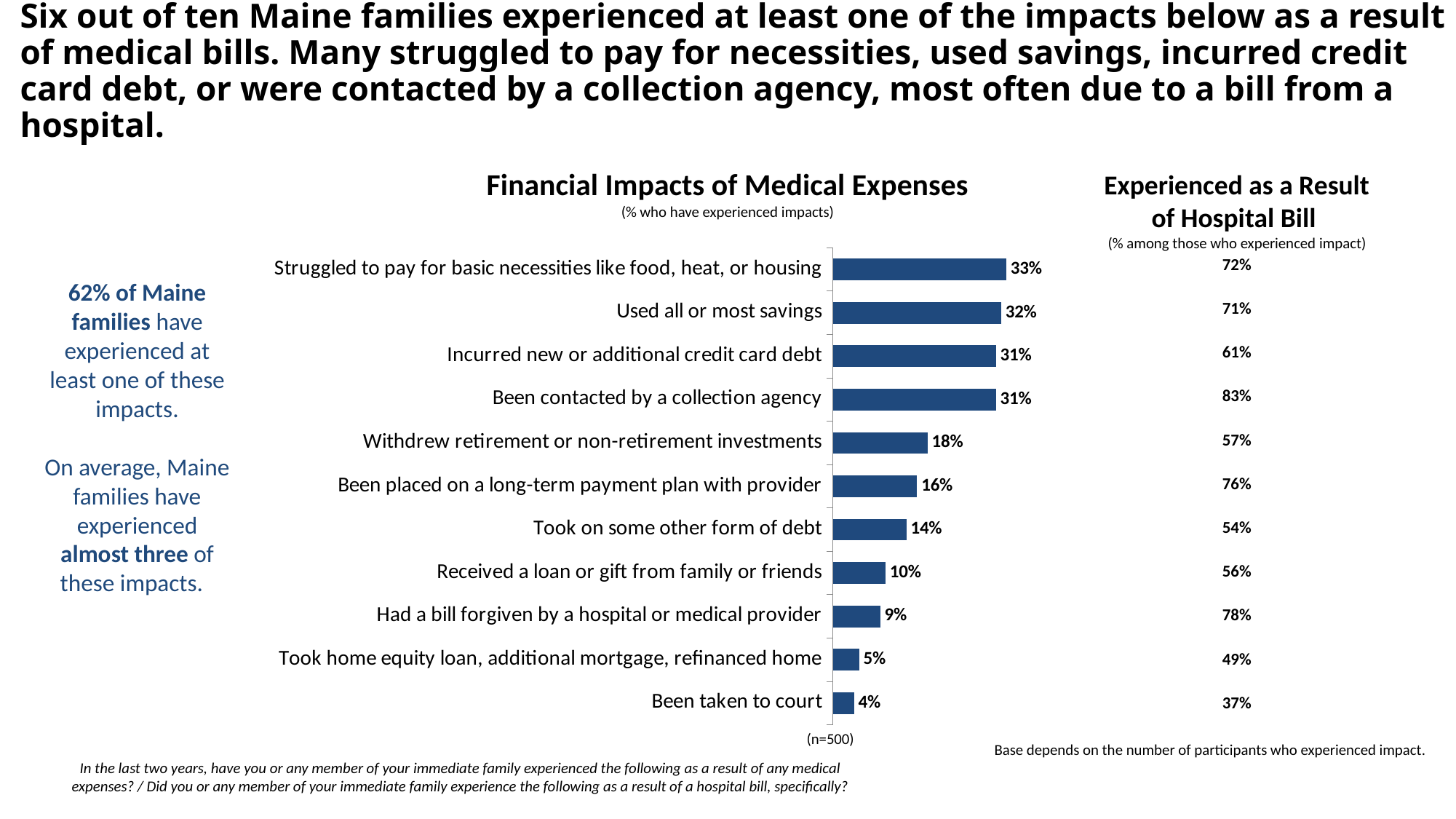
In the Financial Impacts of Medical Expenses chart, what is the difference between the percentage who used all or most savings and the percentage who took on some other form of debt? 18% In the Financial Impacts of Medical Expenses chart, which is larger: the percentage who received a loan or gift from family or friends, or the percentage who took home equity loan, additional mortgage, refinanced home? Received a loan or gift from family or friends In the Experienced as a Result of Hospital Bill column, what percentage is shown for Been taken to court? 37% What type of chart is the Financial Impacts of Medical Expenses chart? Bar chart In the Financial Impacts of Medical Expenses chart, what percentage withdrew retirement or non-retirement investments? 18% How many impact categories are shown in the Financial Impacts of Medical Expenses chart? 11 In the Financial Impacts of Medical Expenses chart, what percentage struggled to pay for basic necessities like food, heat, or housing? 33% In the Financial Impacts of Medical Expenses chart, which impact has the lowest percentage? Been taken to court In the Financial Impacts of Medical Expenses chart, what percentage had a bill forgiven by a hospital or medical provider? 9% What is the sample size (n) noted below the Financial Impacts of Medical Expenses chart? n=500 In the Financial Impacts of Medical Expenses chart, which impact has the highest percentage? Struggled to pay for basic necessities like food, heat, or housing In the Experienced as a Result of Hospital Bill column, what percentage is shown for Been contacted by a collection agency? 83%